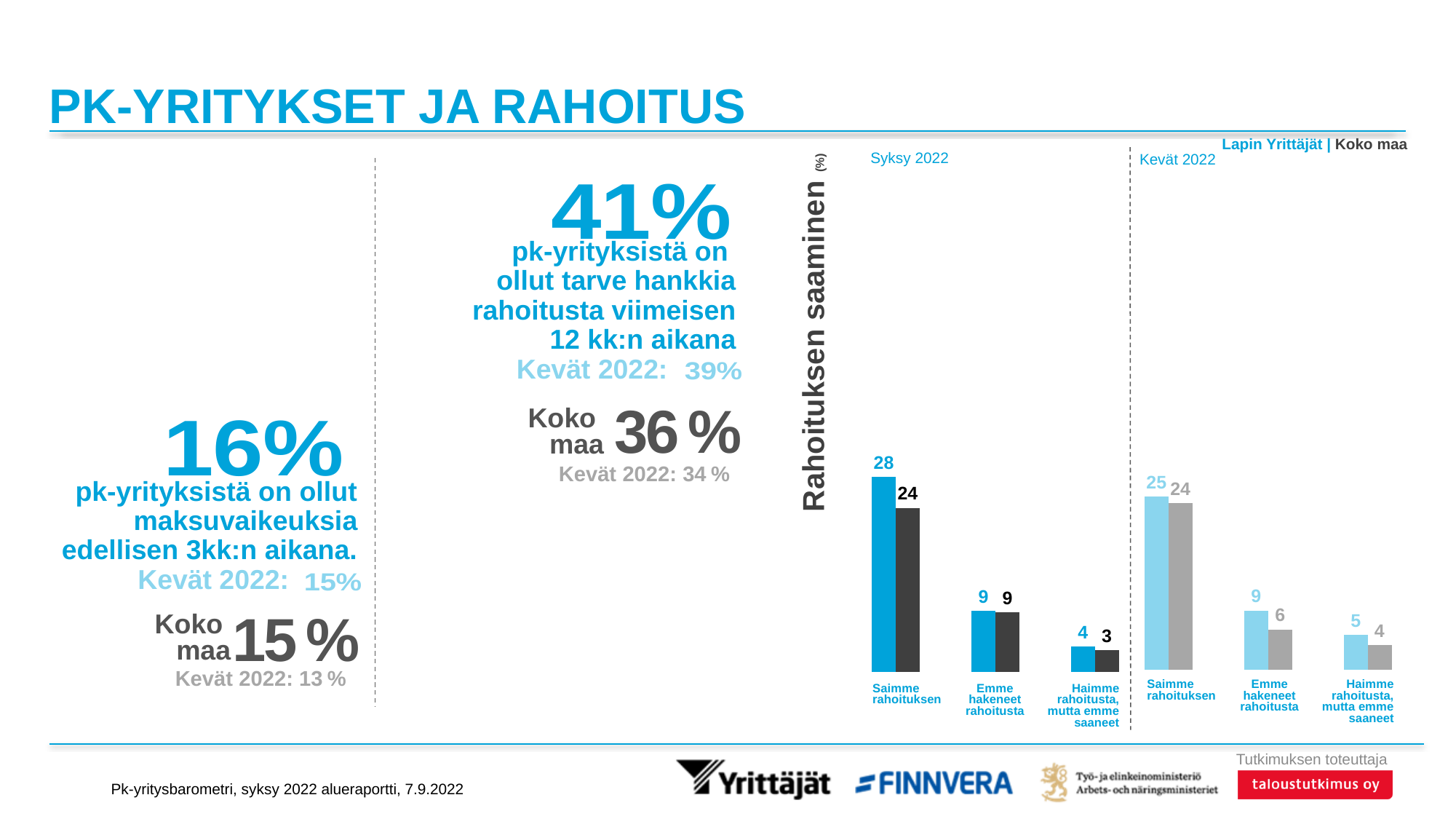
In the Rahoituksen saaminen chart, which category has the highest Syksy 2022 value for Lapin Yrittäjät? Saimme rahoituksen In the Rahoituksen saaminen chart, what is the difference between the Syksy 2022 and Kevät 2022 values of Lapin Yrittäjät for Saimme rahoituksen? 3 In the Rahoituksen saaminen chart, how many categories are shown in the Syksy 2022 panel? 3 In the Rahoituksen saaminen chart, what is the Kevät 2022 value for Koko maa in the category Haimme rahoitusta, mutta emme saaneet? 4 In the Rahoituksen saaminen chart, for Emme hakeneet rahoitusta in Kevät 2022, which is larger: Lapin Yrittäjät or Koko maa? Lapin Yrittäjät In the Rahoituksen saaminen chart, how many series are shown in the legend? 2 What kind of chart is the Rahoituksen saaminen chart? bar chart In the Rahoituksen saaminen chart, what is the difference between the Syksy 2022 values of Lapin Yrittäjät and Koko maa for Saimme rahoituksen? 4 In the Rahoituksen saaminen chart, what is the Syksy 2022 value for Lapin Yrittäjät in the category Saimme rahoituksen? 28 In the Rahoituksen saaminen chart, what is the Syksy 2022 value for Koko maa in the category Saimme rahoituksen? 24 In the Rahoituksen saaminen chart, which category has the lowest Syksy 2022 value for Koko maa? Haimme rahoitusta, mutta emme saaneet In the Rahoituksen saaminen chart, what is the Kevät 2022 value for Lapin Yrittäjät in the category Emme hakeneet rahoitusta? 9